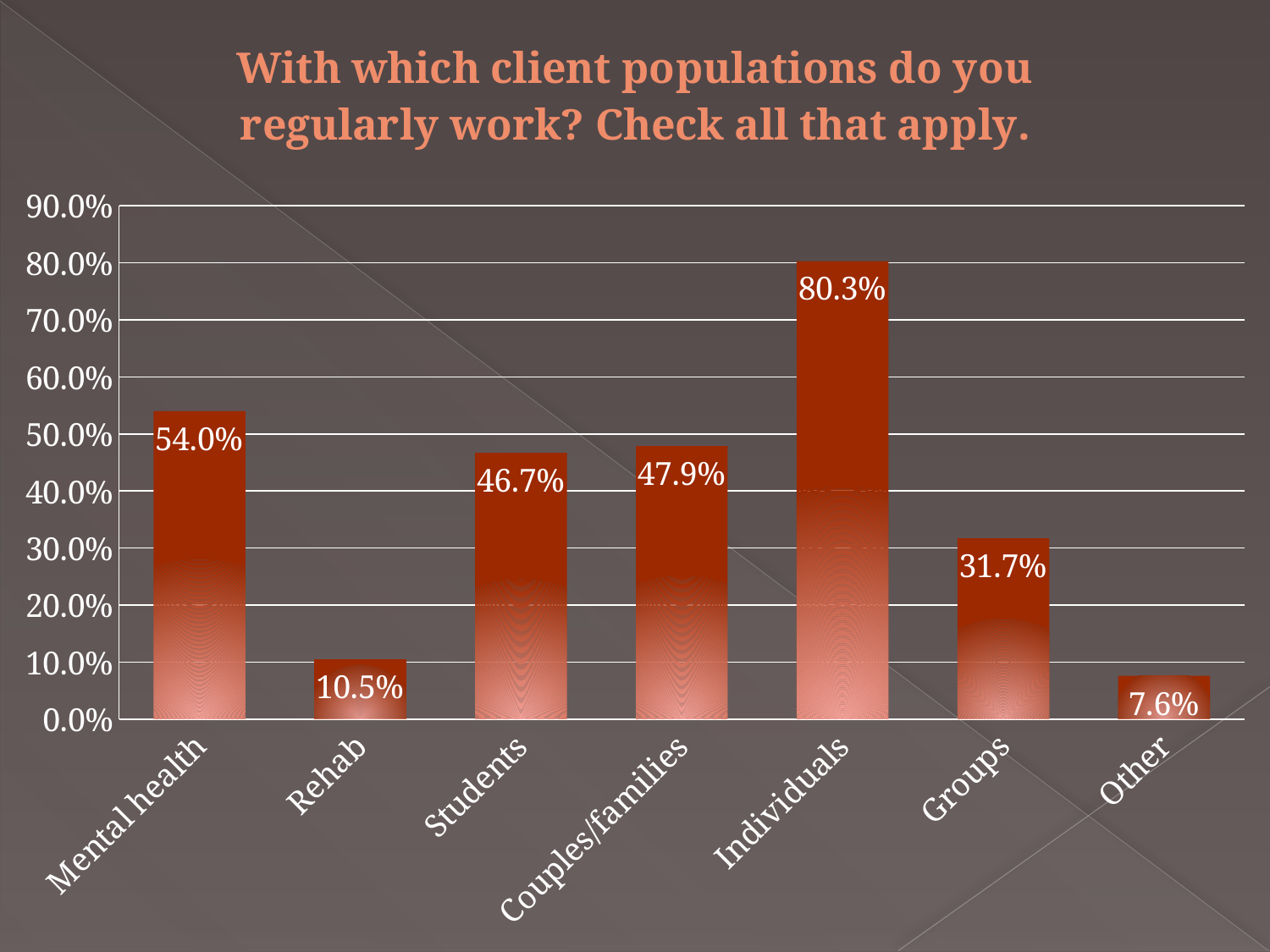
What is the title of the chart? With which client populations do you regularly work? Check all that apply. Which category has the highest value? Individuals What is the difference between the values for Groups and Rehab? 21.2% Which category has the lowest value? Other What is the difference between the values for Individuals and Mental health? 26.3% How many categories are shown on the x axis? 7 Which is larger, the value for Mental health or the value for Students? Mental health What is the value for Couples/families? 47.9% What is the value for Individuals? 80.3% Is the value for Groups greater or less than 40.0%? less What is the value for Rehab? 10.5% What kind of chart is shown on the slide? bar chart